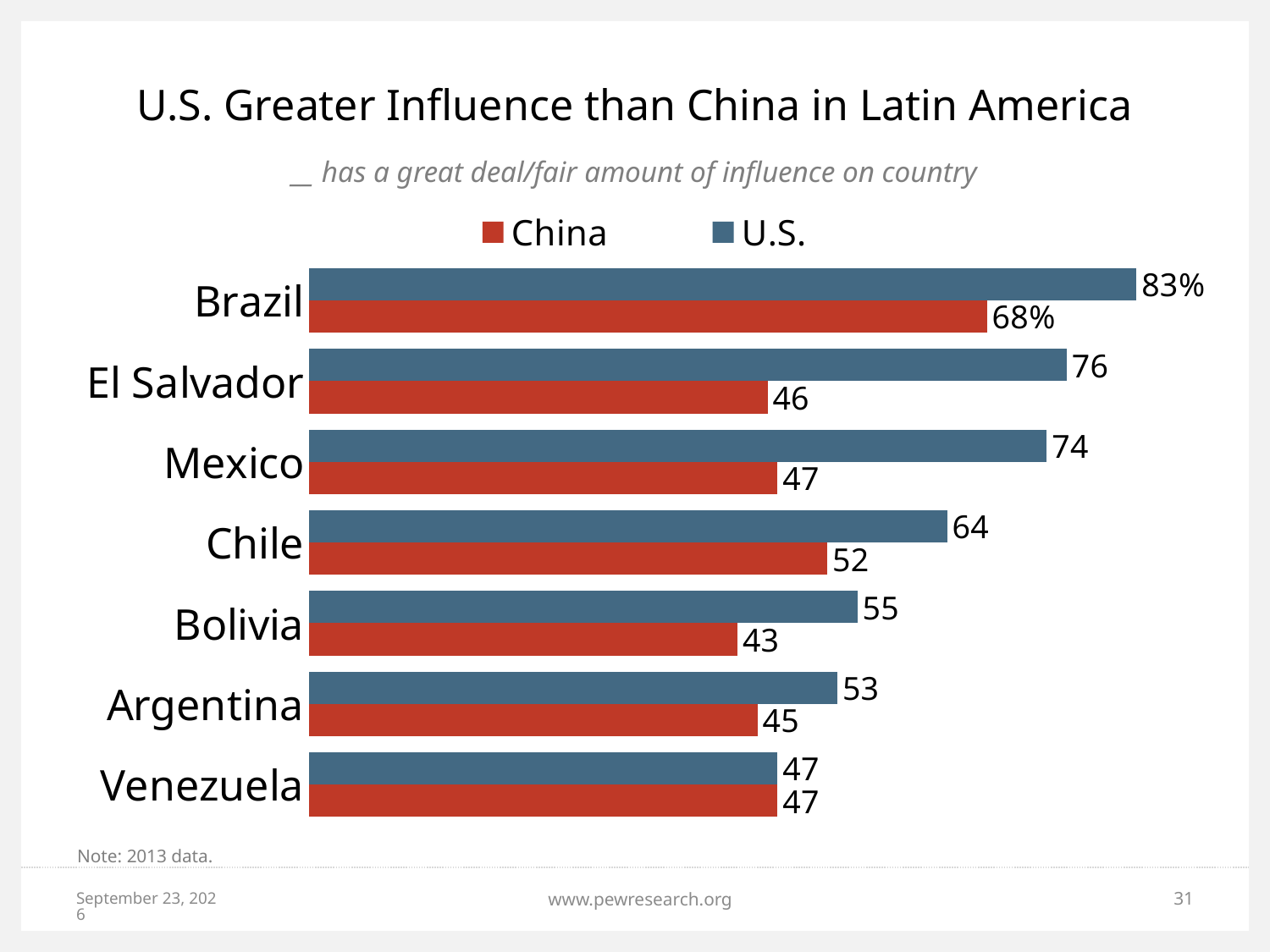
What is the China value for El Salvador? 46 How many countries are shown in the chart? 7 Which is larger for Mexico, the U.S. value or the China value? U.S. Which country has the highest U.S. value? Brazil Which colour represents China in the chart? Red What kind of chart is shown on the slide? Bar chart How many series does the legend list? 2 What is the difference between the U.S. and China values for El Salvador? 30 What is the U.S. value for Brazil? 83% What is the China value for Chile? 52 Which country has the lowest China value? Bolivia What is the title of the chart? U.S. Greater Influence than China in Latin America